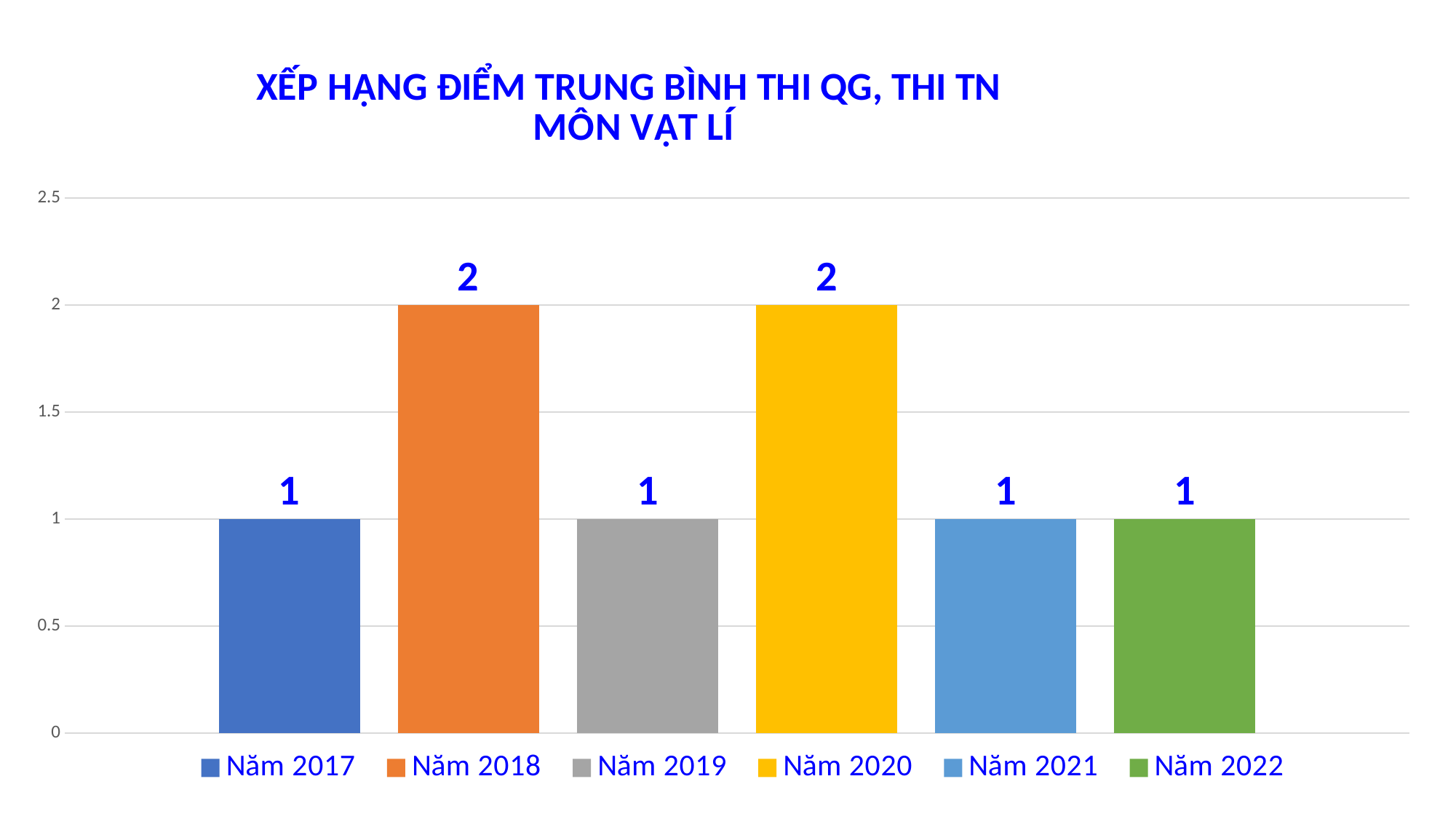
Is the value for Năm 2021 greater or less than 1.5? less What is the value for Năm 2017? 1 How many entries does the legend list? 6 What colour is the bar for Năm 2020? yellow What is the value for Năm 2020? 2 What is the value for Năm 2018? 2 What is the value for Năm 2022? 1 Which is larger, the value for Năm 2020 or the value for Năm 2021? Năm 2020 What kind of chart is shown on the slide? bar chart What is the difference between the values for Năm 2018 and Năm 2019? 1 How many bars are plotted on the chart? 6 Is the value for Năm 2018 greater or less than 1.5? greater